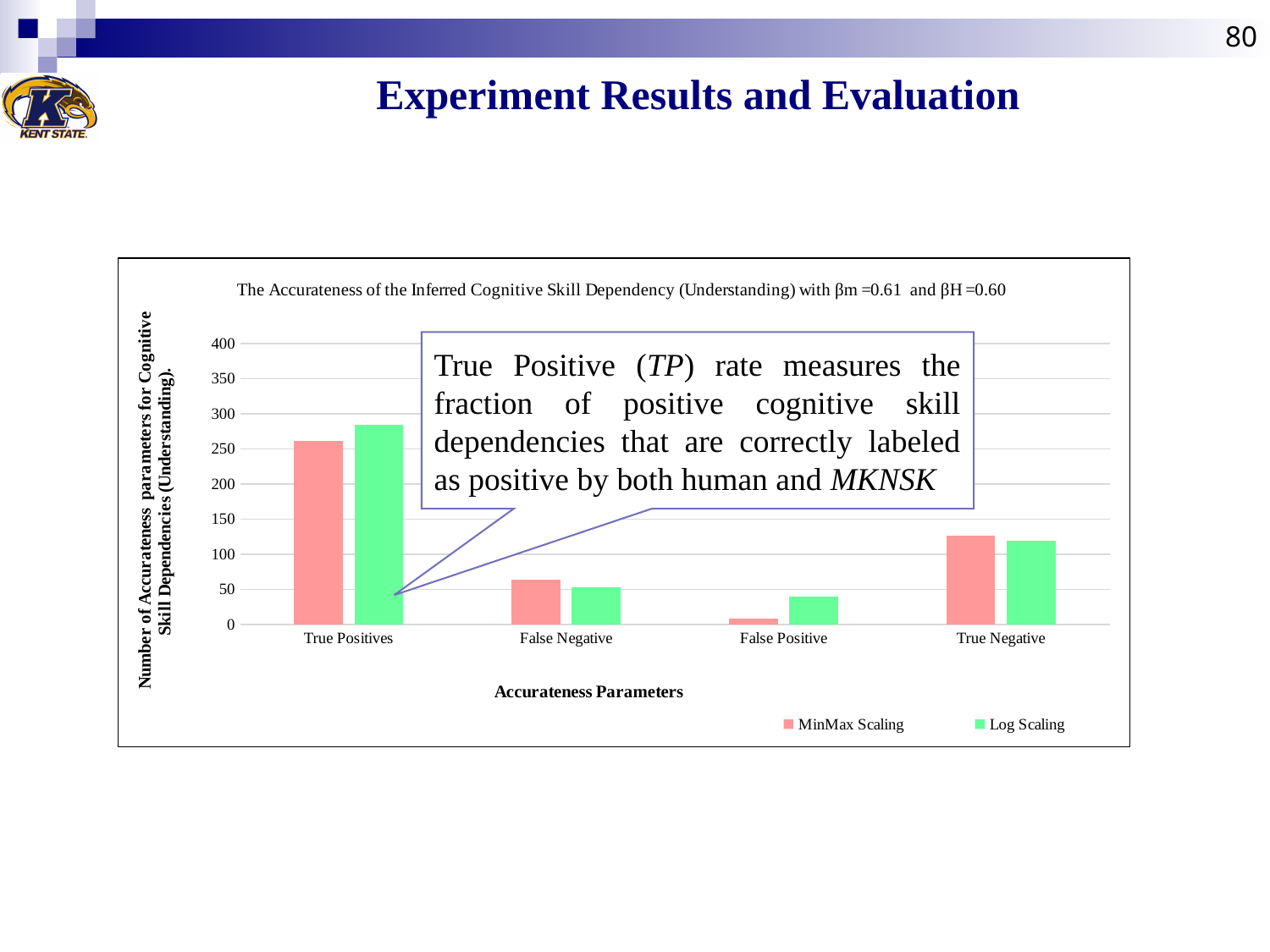
Which category has the lowest value for MinMax Scaling? False Positive Which category has the highest value for MinMax Scaling? True Positives For True Positives, which series has the larger value, MinMax Scaling or Log Scaling? Log Scaling Is the MinMax Scaling value for True Negative greater or less than 100? greater Which category has the lowest value for Log Scaling? False Positive Is the MinMax Scaling value for False Negative greater or less than 100? less How many series does the chart's legend list? 2 Is the Log Scaling value for True Positives greater or less than 250? greater How many categories are shown on the x axis of the chart? 4 What is the title of the x axis of the chart? Accurateness Parameters For False Positive, which series has the larger value, MinMax Scaling or Log Scaling? Log Scaling What kind of chart is shown on the slide? Bar chart